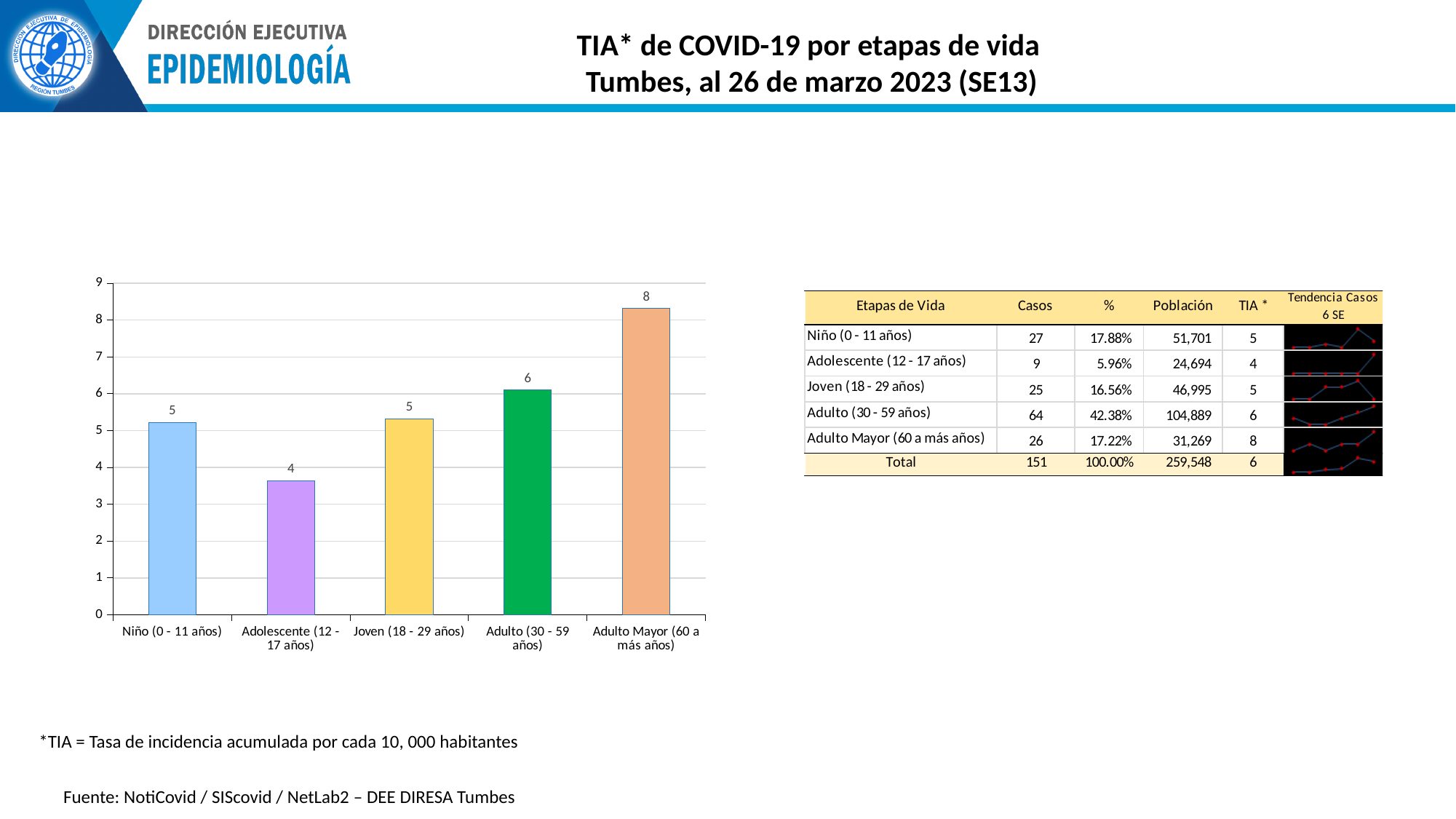
How many age-group categories are plotted in the bar chart? 5 Which has a larger TIA in the bar chart, Adulto (30 - 59 años) or Adolescente (12 - 17 años)? Adulto (30 - 59 años) What is the TIA value shown for Adolescente (12 - 17 años) in the bar chart? 4 What colour is the bar for Adulto (30 - 59 años)? green What is the difference between the labelled TIA values for Adulto Mayor (60 a más años) and Adolescente (12 - 17 años)? 4 Which age group has the lowest TIA in the bar chart? Adolescente (12 - 17 años) Is the bar for Adulto Mayor (60 a más años) greater or less than 7? greater What is the TIA value shown for Niño (0 - 11 años) in the bar chart? 5 What type of chart is shown on the slide? bar chart Which age group has the highest TIA in the bar chart? Adulto Mayor (60 a más años) What is the TIA value shown for Adulto (30 - 59 años) in the bar chart? 6 What is the TIA value shown for Adulto Mayor (60 a más años) in the bar chart? 8